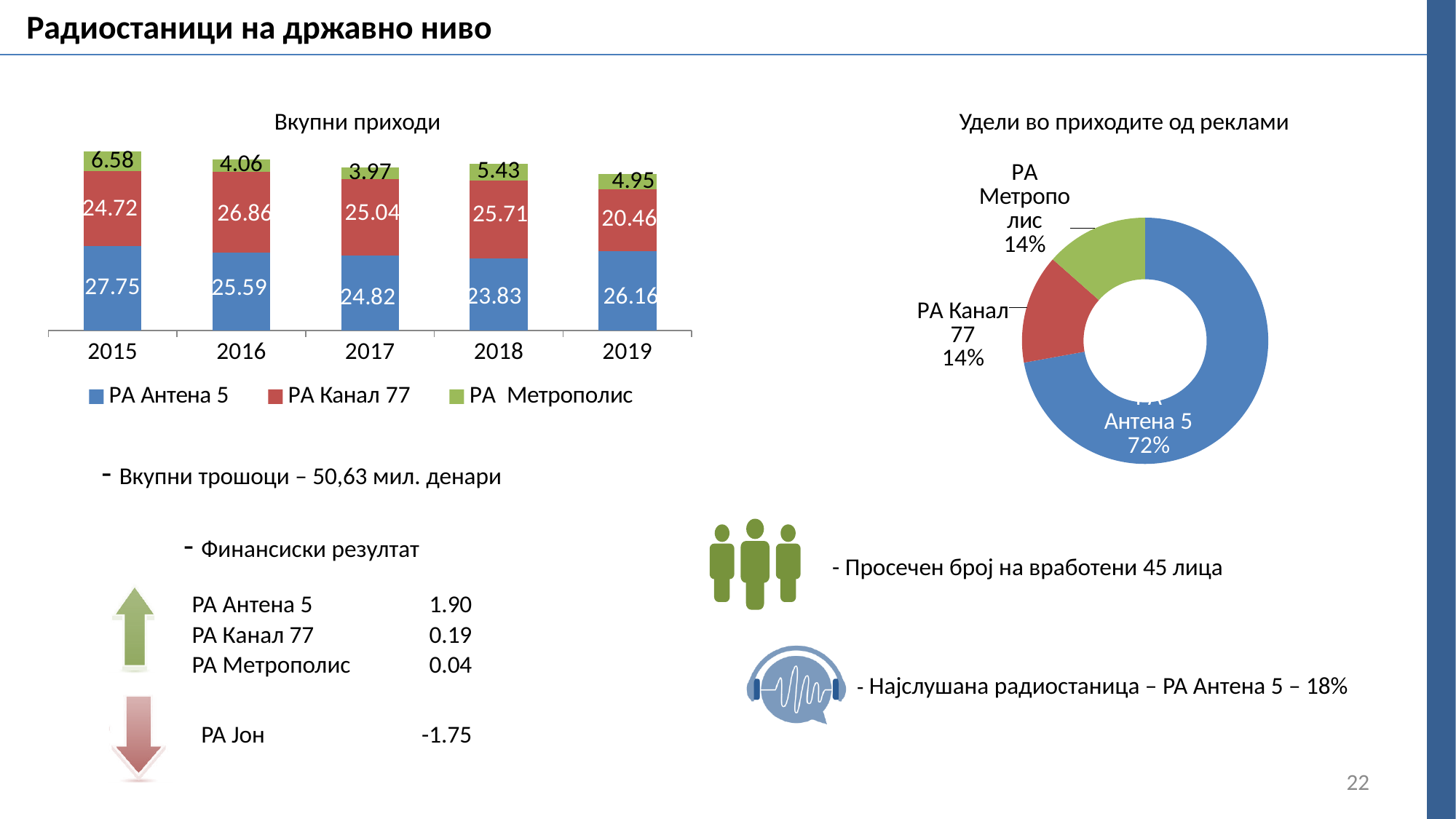
In the 'Вкупни приходи' chart, what is the total of the stacked bar for 2019? 51.57 In the 'Удели во приходите од реклами' chart, what share does РА Антена 5 have? 72% In the 'Вкупни приходи' chart, what is the difference between РА Канал 77 and РА Антена 5 in 2016? 1.27 In the 'Вкупни приходи' chart, how many series does the legend list? 3 In the 'Вкупни приходи' chart, in which year is the value for РА Антена 5 lowest? 2018 In the 'Вкупни приходи' chart, which is larger in 2017: РА Антена 5 or РА Канал 77? РА Канал 77 In the 'Вкупни приходи' chart, what is the value for РА Антена 5 in 2015? 27.75 In the 'Вкупни приходи' chart, what is the value for РА Канал 77 in 2019? 20.46 In the 'Вкупни приходи' chart, in which year is the value for РА Метрополис highest? 2015 In the 'Вкупни приходи' chart, how many years are shown on the x axis? 5 What kind of chart is 'Вкупни приходи'? Stacked bar chart What kind of chart is 'Удели во приходите од реклами'? Doughnut (pie) chart